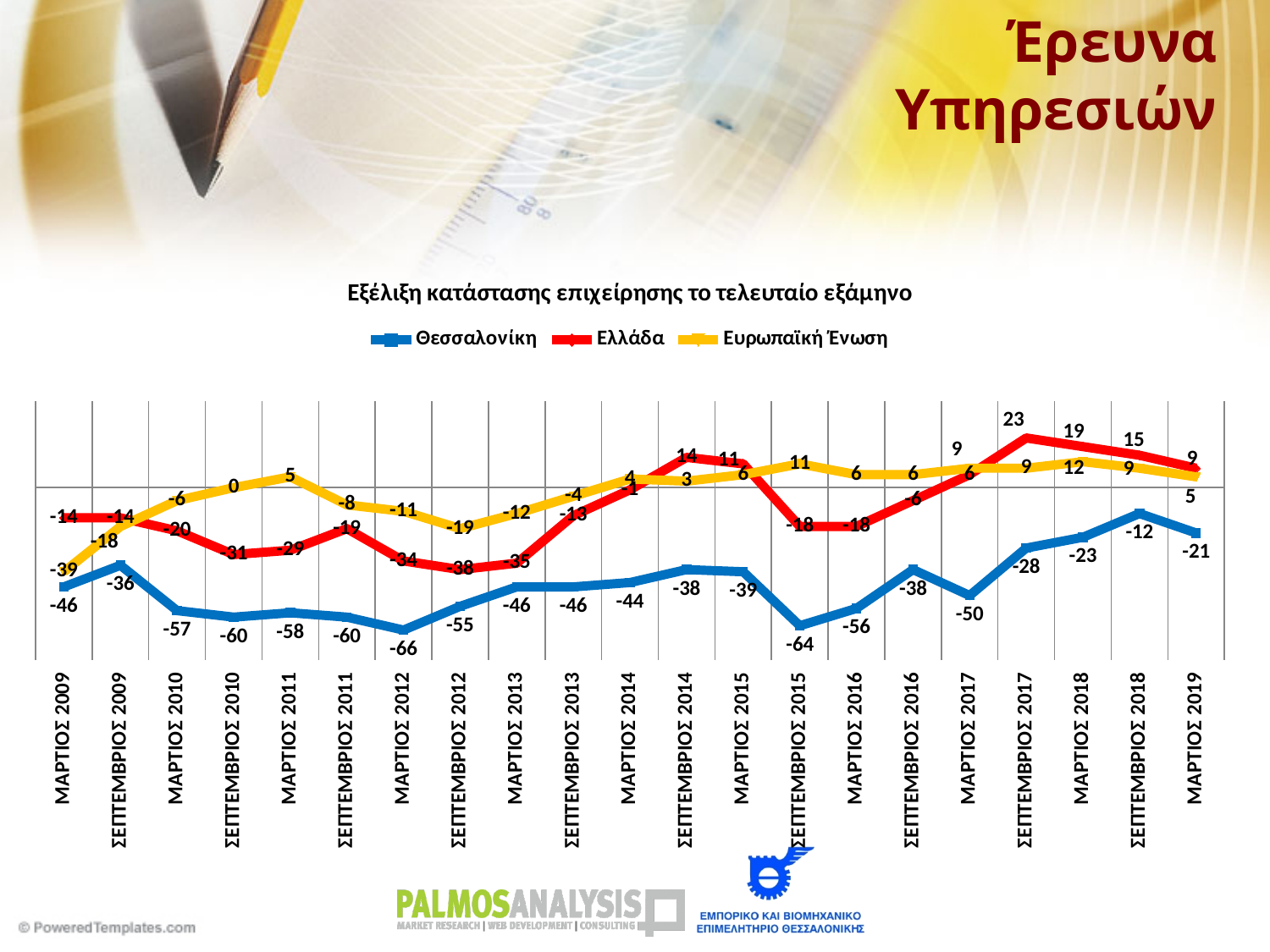
How many series does the legend list? 3 At which time point does Θεσσαλονίκη reach its lowest value? ΜΑΡΤΙΟΣ 2012 What kind of chart is shown on the slide? line chart What is the difference between the Ελλάδα and Θεσσαλονίκη values in ΜΑΡΤΙΟΣ 2019? 30 At which time point does Ελλάδα reach its highest value? ΣΕΠΤΕΜΒΡΙΟΣ 2017 What colour is the line for Ευρωπαϊκή Ένωση? yellow At which time point does Ευρωπαϊκή Ένωση reach its highest value? ΜΑΡΤΙΟΣ 2018 What is the value for Ευρωπαϊκή Ένωση in ΜΑΡΤΙΟΣ 2009? -39 What is the value for Ελλάδα in ΣΕΠΤΕΜΒΡΙΟΣ 2017? 23 How many time points are plotted along the x axis? 21 In ΣΕΠΤΕΜΒΡΙΟΣ 2015, which is larger: the value for Ελλάδα or for Ευρωπαϊκή Ένωση? Ευρωπαϊκή Ένωση What is the value for Θεσσαλονίκη in ΜΑΡΤΙΟΣ 2012? -66